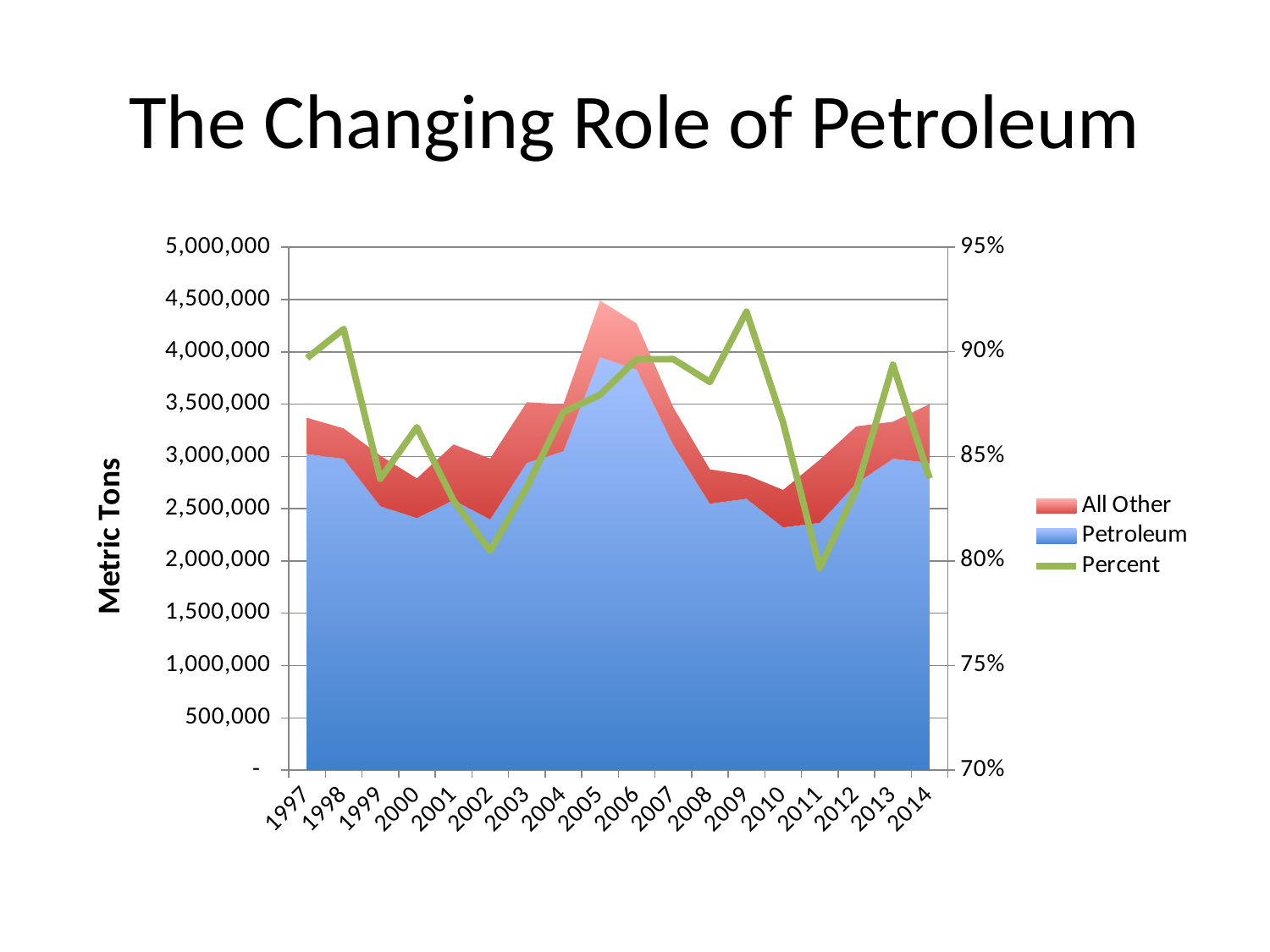
Is the Petroleum value for 2005 greater or less than 3,500,000? greater In which year is the Percent line at its lowest? 2011 Does the Petroleum area rise or fall from 2005 to 2010? fall Is the Petroleum value for 2010 greater or less than 2,500,000? less What are the three series named in the legend? All Other, Petroleum, Percent How many series does the legend list? 3 In which year does the Petroleum area reach its highest value? 2005 What is the title of the left vertical axis? Metric Tons Is the Percent value for 2002 greater or less than 85%? less How many years are shown along the x axis? 18 What kind of chart is this? A stacked area chart combined with a line chart